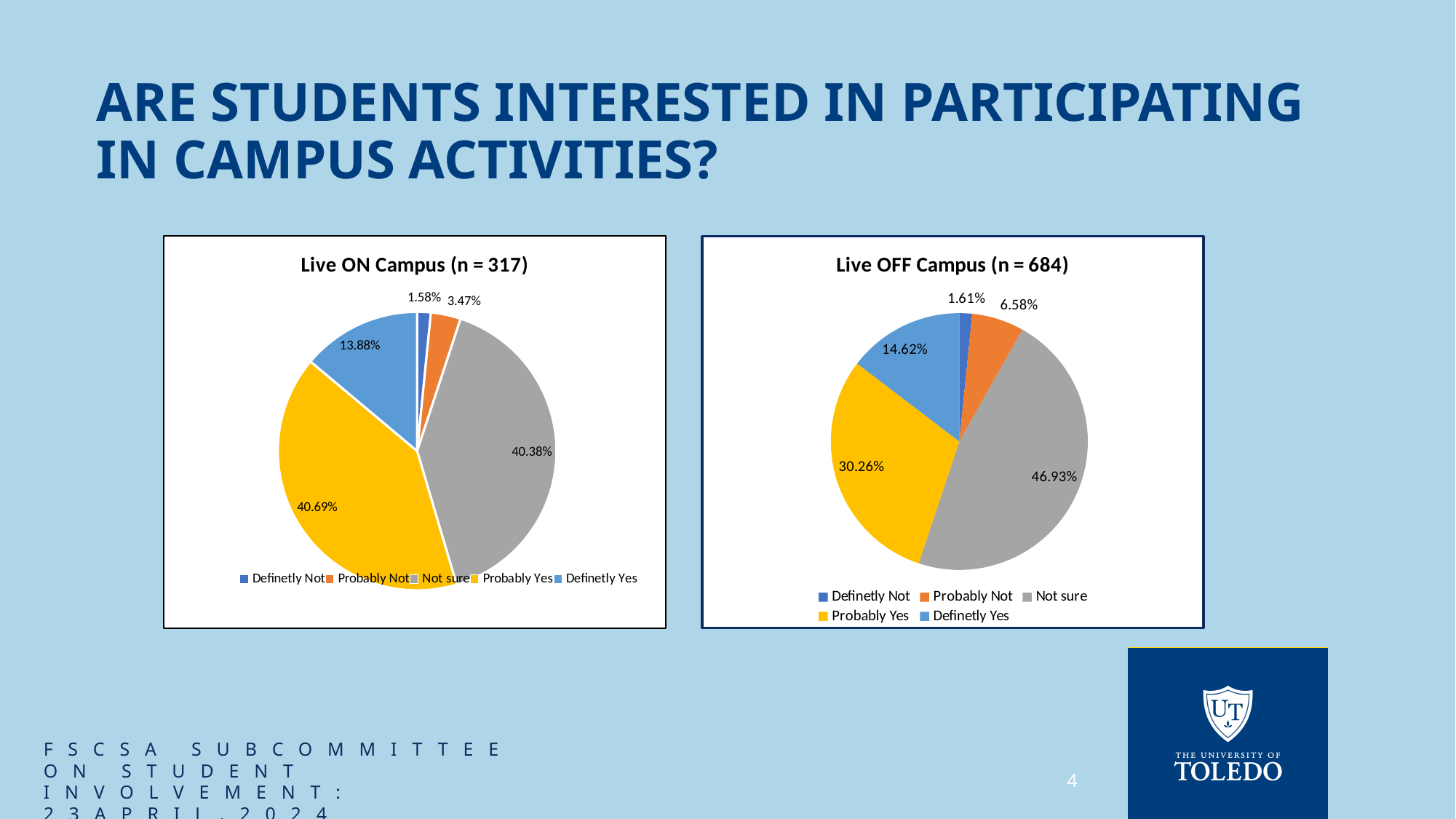
How many slices does the Live OFF Campus (n = 684) pie chart have? 5 What type of chart is the Live ON Campus (n = 317) chart? Pie chart In the Live OFF Campus (n = 684) chart, what percentage of students answered Probably Not? 6.58% In the Live ON Campus (n = 317) chart, what percentage of students answered Definetly Yes? 13.88% In the Live OFF Campus (n = 684) chart, which response has the largest share? Not sure In the Live OFF Campus (n = 684) chart, what colour is the Not sure slice? Gray What is the difference between the Not sure share in the Live OFF Campus chart and the Not sure share in the Live ON Campus chart? 6.55% In the Live OFF Campus (n = 684) chart, which response has the smallest share? Definetly Not In the Live ON Campus (n = 317) chart, which is larger: the Definetly Yes share or the Probably Not share? Definetly Yes In the Live ON Campus (n = 317) chart, which response has the smallest share? Definetly Not In the Live ON Campus (n = 317) chart, what percentage of students answered Not sure? 40.38% In the Live OFF Campus (n = 684) chart, what percentage of students answered Probably Yes? 30.26%